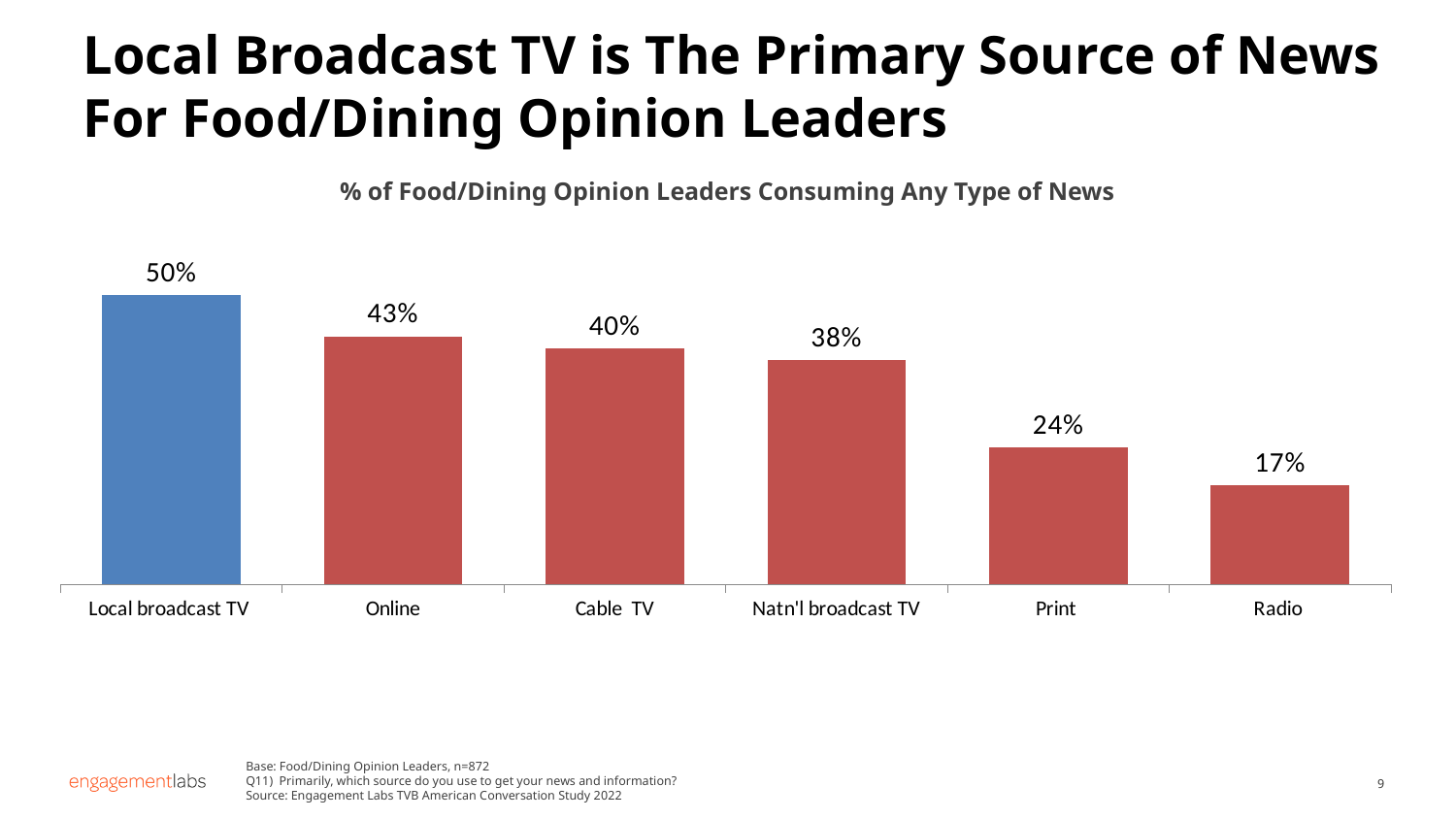
Which news source has the highest percentage? Local broadcast TV What is the value shown for Print? 24% What is the value shown for Online? 43% Do the values rise or fall from left to right across the chart? Fall What is the difference between the values for Local broadcast TV and Radio? 33% Which is larger, the value for Online or the value for Print? Online What is the difference between the values for Cable TV and Natn'l broadcast TV? 2% Which news source has the lowest percentage? Radio Which bar is coloured differently from the others? Local broadcast TV What kind of chart is shown on the slide? Bar chart How many news sources are shown in the chart? 6 What percentage of Food/Dining Opinion Leaders use Local broadcast TV as their news source? 50%